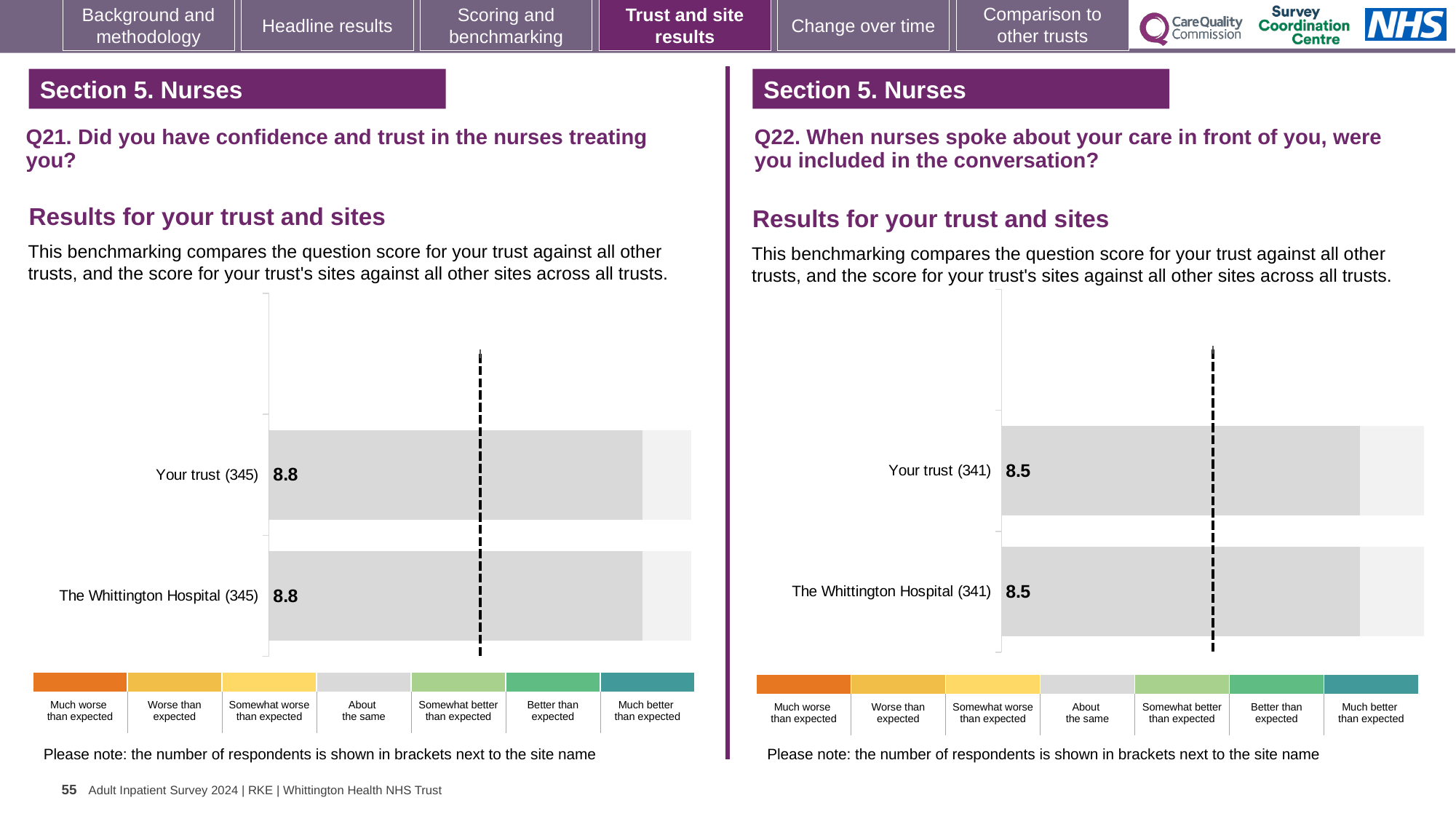
On the Q22 chart (right), what is the score for The Whittington Hospital? 8.5 On the Q22 chart (right), how many respondents are shown in brackets next to The Whittington Hospital? 341 On the Q22 chart (right), what is the score for Your trust? 8.5 On the Q21 chart (left), what is the difference between the score for Your trust and the score for The Whittington Hospital? 0 What kind of chart is the Q21 chart (left)? Bar chart On the Q22 chart (right), what is the difference between the score for Your trust and the score for The Whittington Hospital? 0 On the Q21 chart (left), what is the score for Your trust? 8.8 How many bars are plotted on the Q22 chart (right)? 2 How many bars are plotted on the Q21 chart (left)? 2 On the Q21 chart (left), what is the score for The Whittington Hospital? 8.8 Is the score for Your trust on the Q21 chart (left) larger or smaller than the score for Your trust on the Q22 chart (right)? Larger On the Q21 chart (left), how many respondents are shown in brackets next to Your trust? 345